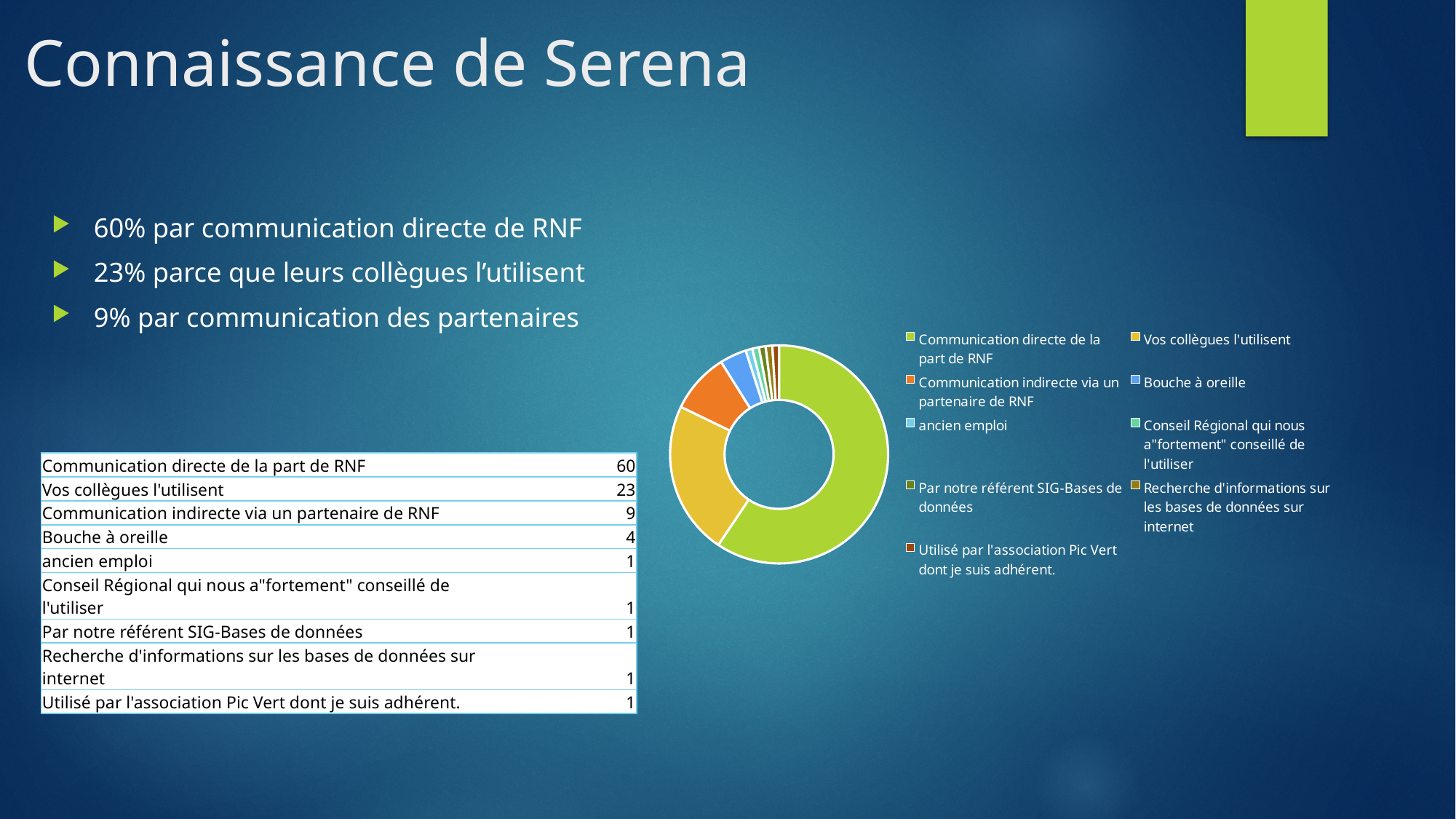
What is the value for "Bouche à oreille"? 4 What is the value for "Communication directe de la part de RNF"? 60 What is the value for "Communication indirecte via un partenaire de RNF"? 9 What is the value for "Vos collègues l'utilisent"? 23 How many categories does the chart's legend list? 9 Which category has the largest slice in the chart? Communication directe de la part de RNF Which is larger, the value for "Vos collègues l'utilisent" or the value for "Communication indirecte via un partenaire de RNF"? Vos collègues l'utilisent What kind of chart is shown on the slide? Doughnut (pie) chart What is the difference between the values for "Vos collègues l'utilisent" and "Bouche à oreille"? 19 What is the difference between the values for "Communication directe de la part de RNF" and "Vos collègues l'utilisent"? 37 What is the value for "ancien emploi"? 1 What colour is the slice for "Communication indirecte via un partenaire de RNF"? Orange